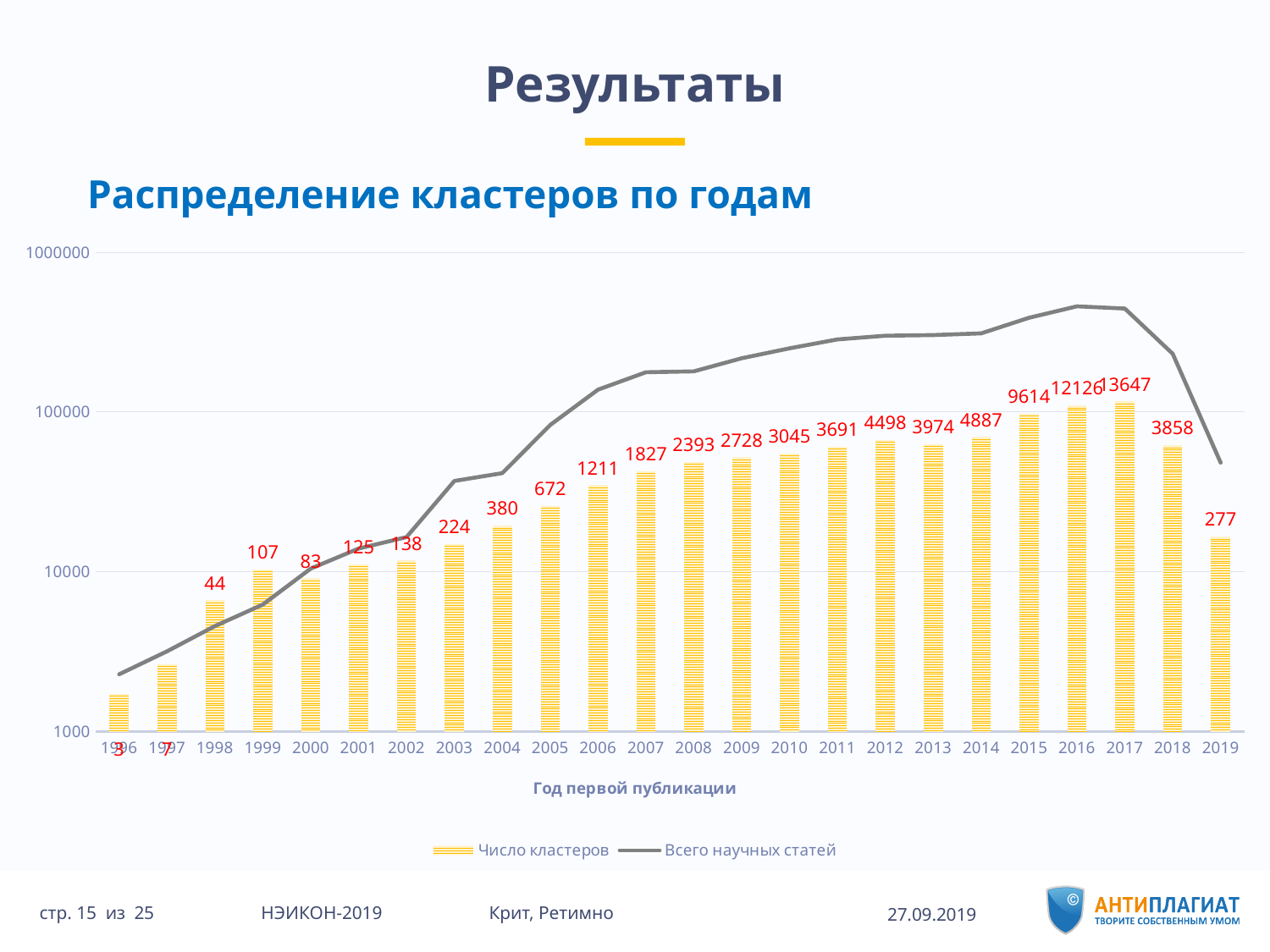
Which year has the highest number of clusters? 2017 Which year has the lowest number of clusters? 1996 What is the number of clusters (Число кластеров) for 2017? 13647 What is the difference between the number of clusters in 2017 and in 2016? 1521 What is the title of the x axis? Год первой публикации How many years are shown on the x axis? 24 What is the difference between the number of clusters in 2018 and in 2019? 3581 What is the number of clusters (Число кластеров) for 2019? 277 Is the value of the 'Всего научных статей' line for 2017 greater or less than 100000? greater What is the number of clusters (Число кластеров) for 2005? 672 Which year has more clusters, 2012 or 2013? 2012 How many series does the legend list? 2